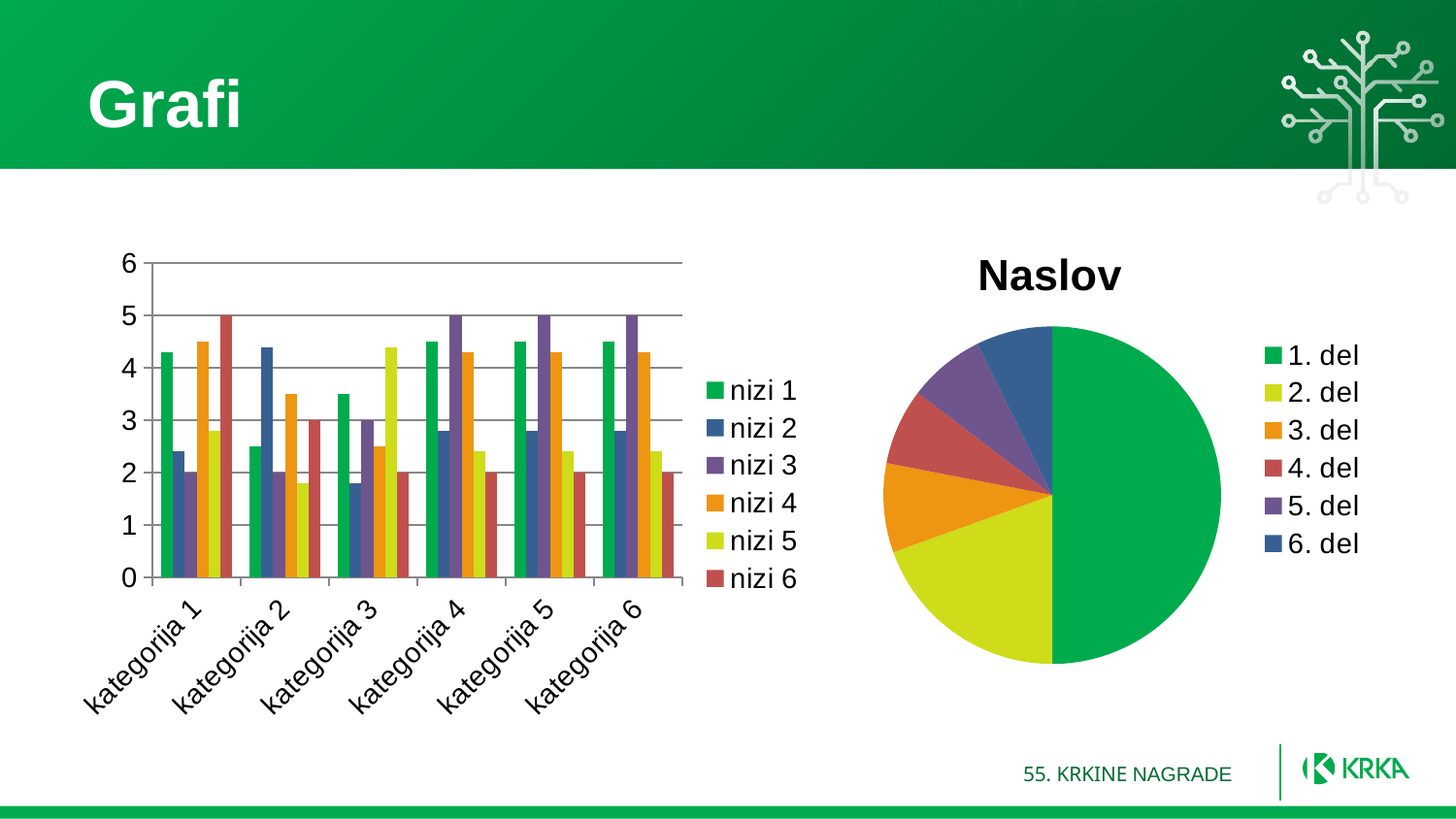
In the bar chart on the left, how many categories are shown on the x axis? 6 In the bar chart on the left, what is the value of nizi 3 for kategorija 4? 5 In the bar chart on the left, for kategorija 1, which is larger: nizi 6 or nizi 2? nizi 6 In the pie chart titled "Naslov", how many slices are there? 6 In the bar chart on the left, what is the value of nizi 6 for kategorija 1? 5 What kind of chart is the chart on the left of the slide? bar chart In the pie chart titled "Naslov", which slice is the largest? 1. del What kind of chart is the chart titled "Naslov"? pie chart In the bar chart on the left, which series has the highest value for kategorija 4? nizi 3 In the bar chart on the left, is the value of nizi 5 for kategorija 2 greater or less than 2? less In the bar chart on the left, is the value of nizi 1 for kategorija 1 greater or less than 4? greater In the bar chart on the left, how many series does the legend list? 6